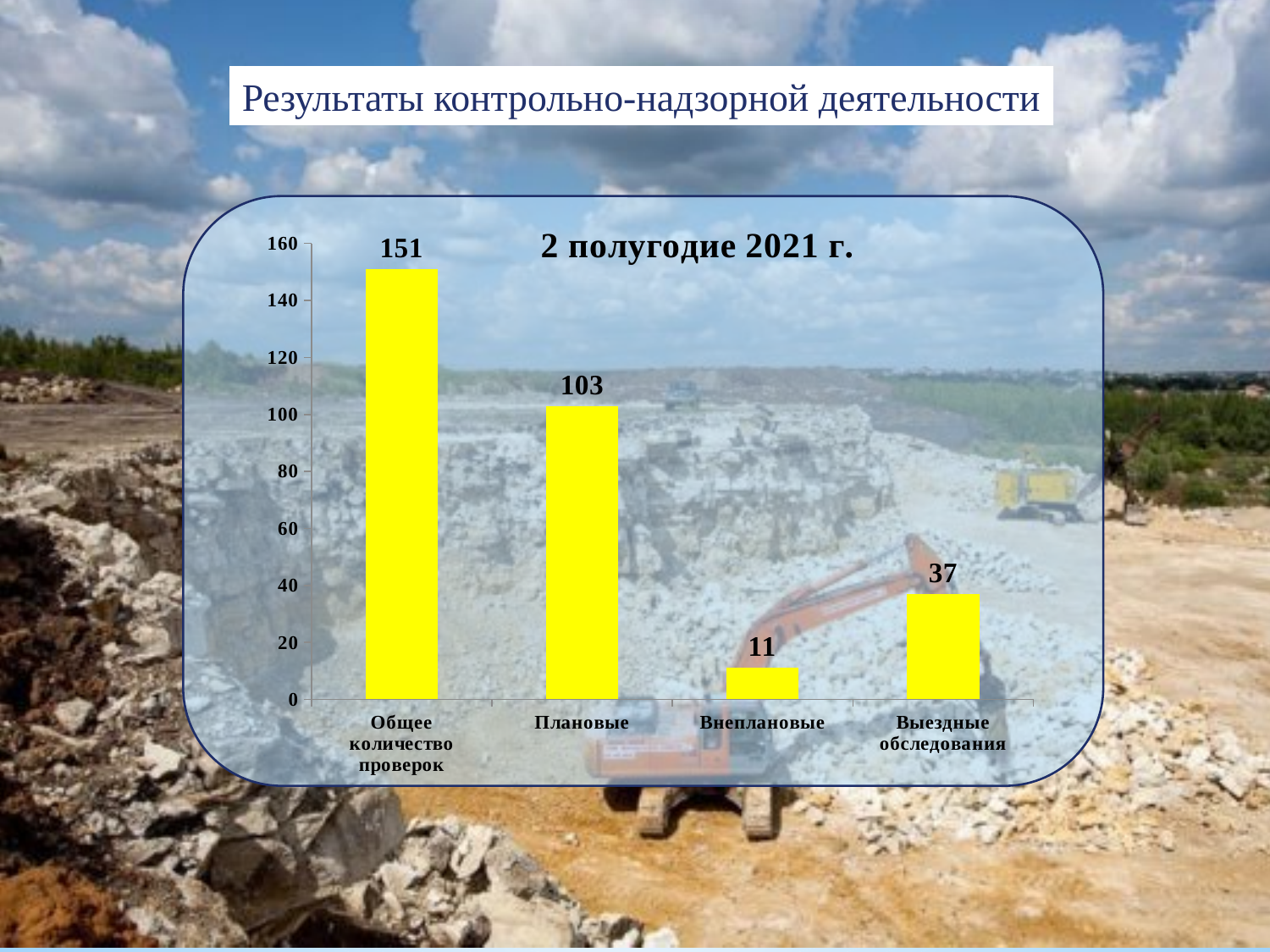
What is the value for Общее количество проверок? 151 What is the value for Плановые? 103 Is the value for Плановые greater or less than 100? greater What is the value for Внеплановые? 11 Which category has the lowest value? Внеплановые What is the title of the chart? 2 полугодие 2021 г. How many categories are shown in the chart? 4 What is the value for Выездные обследования? 37 What is the difference between Плановые and Внеплановые? 92 Which is larger, Выездные обследования or Внеплановые? Выездные обследования What kind of chart is shown on the slide? bar chart Which category has the highest value? Общее количество проверок